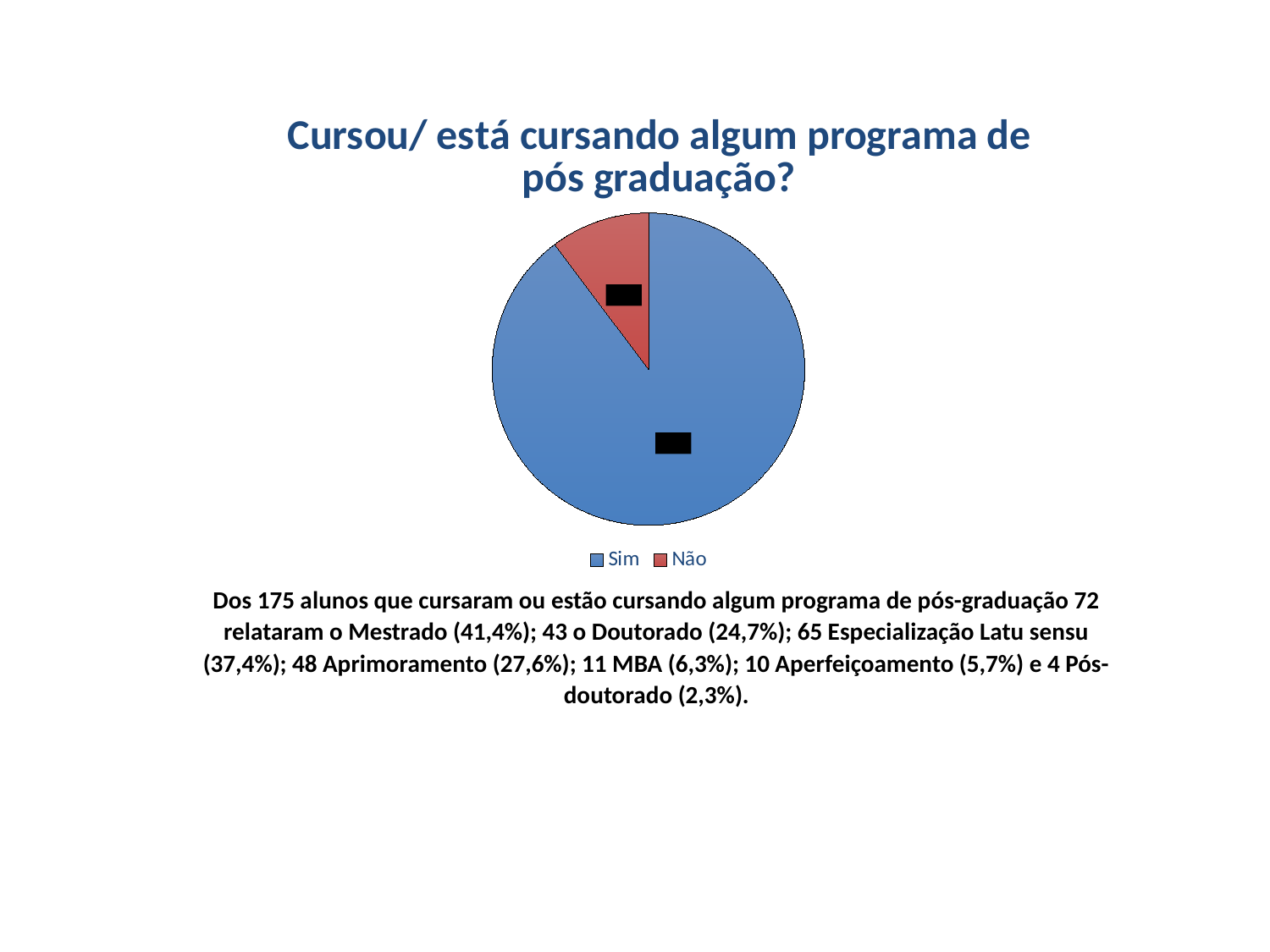
What kind of chart is shown on the slide? pie chart How many slices does the pie chart have? 2 How many entries does the legend list? 2 Which slice is larger, Sim or Não? Sim Which category has the smallest slice of the pie? Não What is the title of the chart? Cursou/ está cursando algum programa de pós graduação? What colour is the slice for Não? red Which category has the largest slice of the pie? Sim Which legend entry is shown in blue? Sim